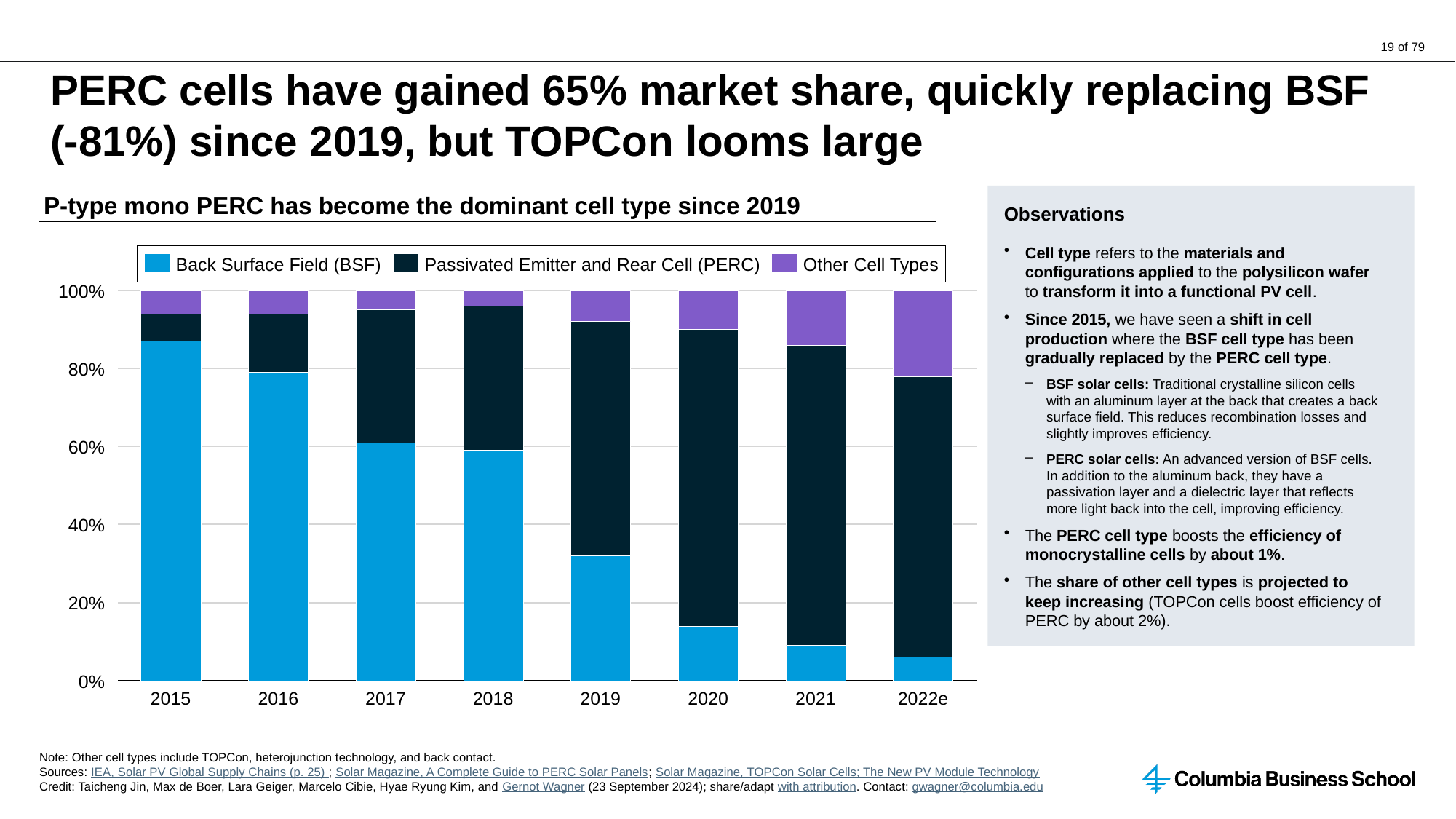
Is the Back Surface Field (BSF) share in 2015 greater or less than 80%? greater Which year has the larger Back Surface Field (BSF) share, 2017 or 2019? 2017 How many years are shown on the x axis of the chart? 8 Is the Back Surface Field (BSF) share in 2016 greater or less than 60%? greater Does the Back Surface Field (BSF) share rise or fall from 2015 to 2022e? Falls In which year is the Back Surface Field (BSF) share the highest? 2015 In which year is the Back Surface Field (BSF) share the lowest? 2022e What kind of chart is shown on the slide? Stacked bar chart Is the Back Surface Field (BSF) share in 2019 greater or less than 40%? less How many series does the chart's legend list? 3 In which year is the Other Cell Types share the largest? 2022e